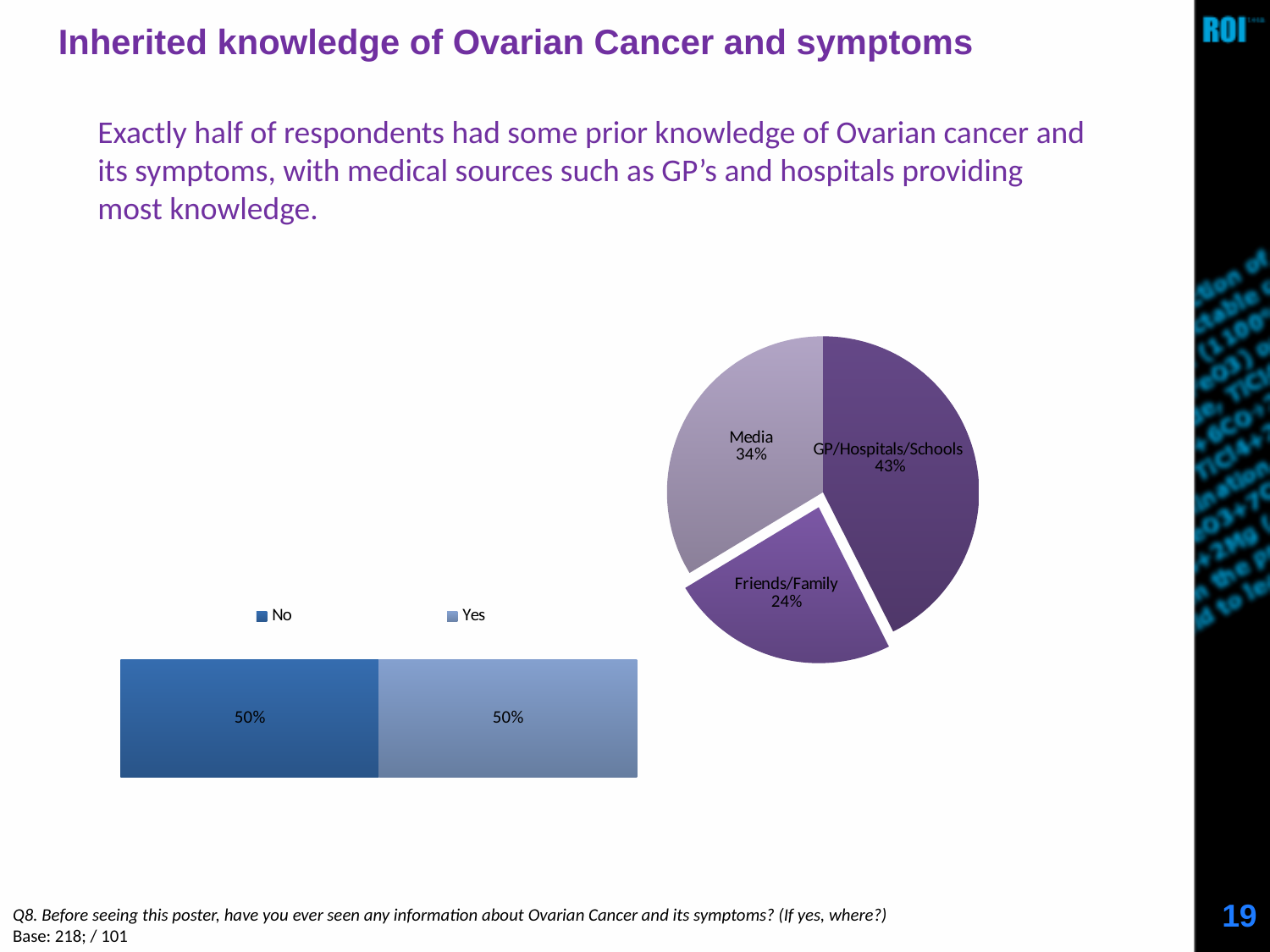
In the pie chart on the right, what share is labelled for GP/Hospitals/Schools? 43% How many slices does the pie chart on the right have? 3 In the pie chart on the right, how many percentage points larger is GP/Hospitals/Schools than Friends/Family? 19 How many series does the legend of the bar chart at the bottom left list? 2 In the pie chart on the right, which is larger, Media or Friends/Family? Media In the pie chart on the right, which source has the smallest slice? Friends/Family What kind of chart is the chart on the right of the slide? Pie chart In the bar chart at the bottom left, what value is shown for No? 50% What kind of chart is the chart at the bottom left of the slide? Bar chart In the pie chart on the right, which source has the largest slice? GP/Hospitals/Schools In the pie chart on the right, what share is labelled for Media? 34% In the pie chart on the right, what share is labelled for Friends/Family? 24%